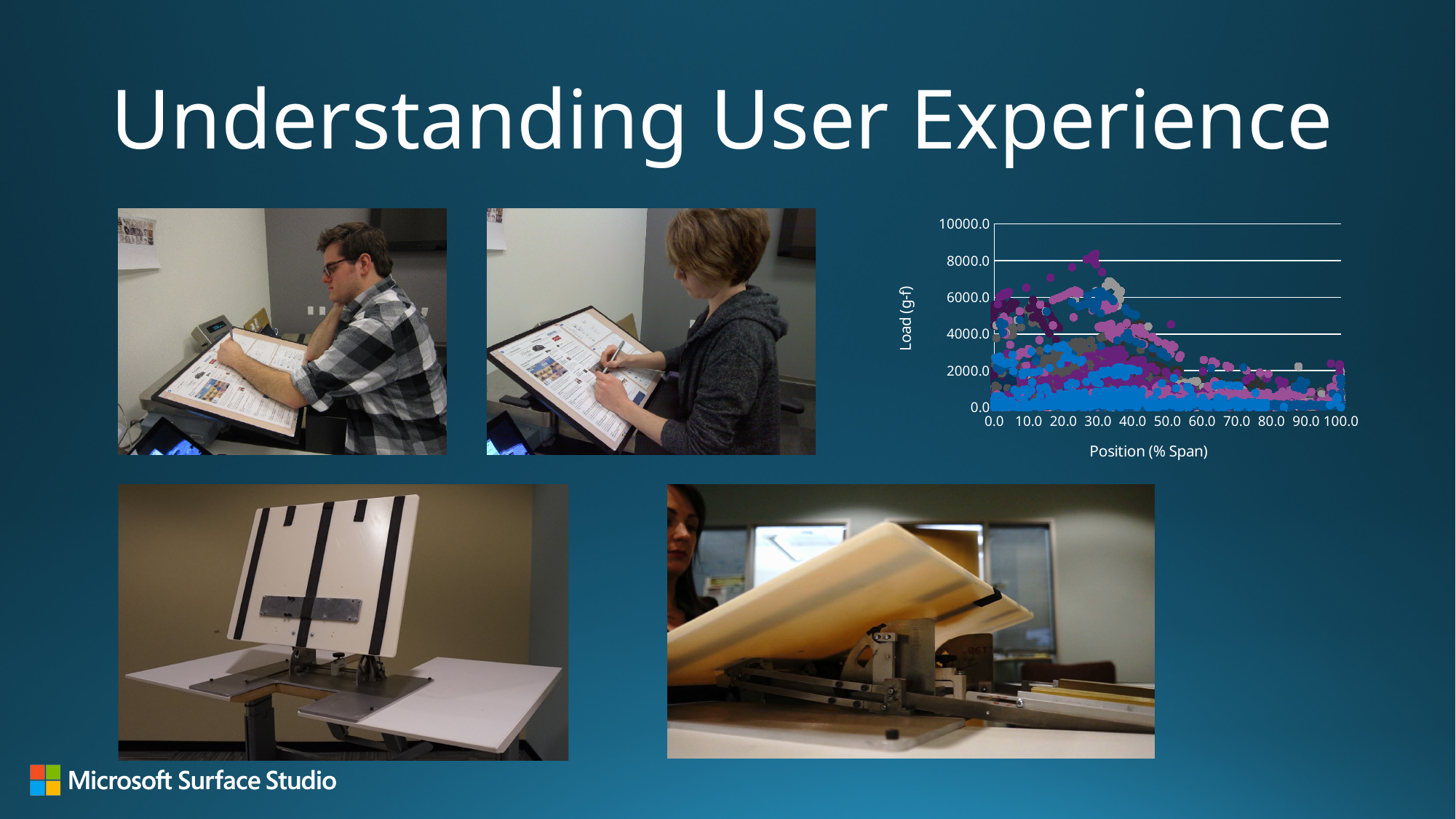
How many tick labels are shown along the x axis of the chart? 11 How many tick labels are shown along the y axis of the chart? 6 Is the highest load value plotted on the chart greater or less than 6000.0? greater Is the highest load value plotted on the chart greater or less than 10000.0? less What is the label of the x axis of the chart? Position (% Span) What is the label of the y axis of the chart? Load (g-f) Are the load values plotted at position 80.0 greater or less than 6000.0? less As position increases from 40.0 to 100.0 on the x axis, do the plotted load values generally rise or fall? fall What kind of chart is shown on the right of the slide? scatter chart